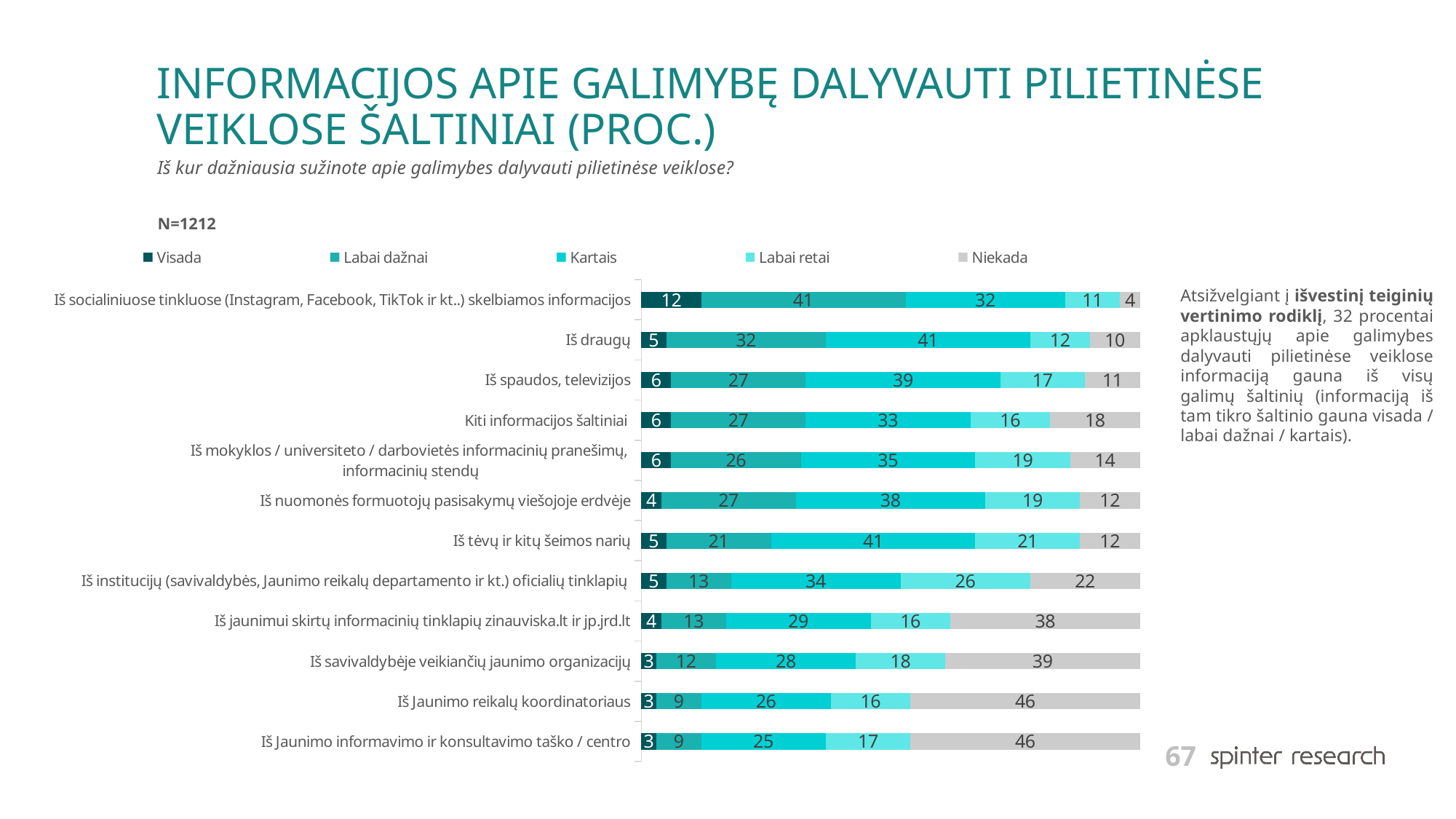
Which is larger: the "Labai retai" value for "Iš institucijų (savivaldybės, Jaunimo reikalų departamento ir kt.) oficialių tinklapių" or for "Iš spaudos, televizijos"? Iš institucijų (savivaldybės, Jaunimo reikalų departamento ir kt.) oficialių tinklapių Which category has the highest "Visada" value? Iš socialiniuose tinkluose (Instagram, Facebook, TikTok ir kt..) skelbiamos informacijos What is the total of the stacked bar for "Iš draugų"? 100 How many categories (information sources) are plotted in the chart? 12 Which category has the lowest "Niekada" value? Iš socialiniuose tinkluose (Instagram, Facebook, TikTok ir kt..) skelbiamos informacijos What sample size (N) is shown on the slide? N=1212 What type of chart is shown on the slide? Stacked bar chart What is the "Labai dažnai" value for "Iš socialiniuose tinkluose (Instagram, Facebook, TikTok ir kt..) skelbiamos informacijos"? 41 What is the "Niekada" value for "Iš Jaunimo reikalų koordinatoriaus"? 46 What is the "Kartais" value for "Iš tėvų ir kitų šeimos narių"? 41 How many series does the legend list? 5 What is the difference between the "Niekada" values for "Iš savivaldybėje veikiančių jaunimo organizacijų" and "Iš draugų"? 29